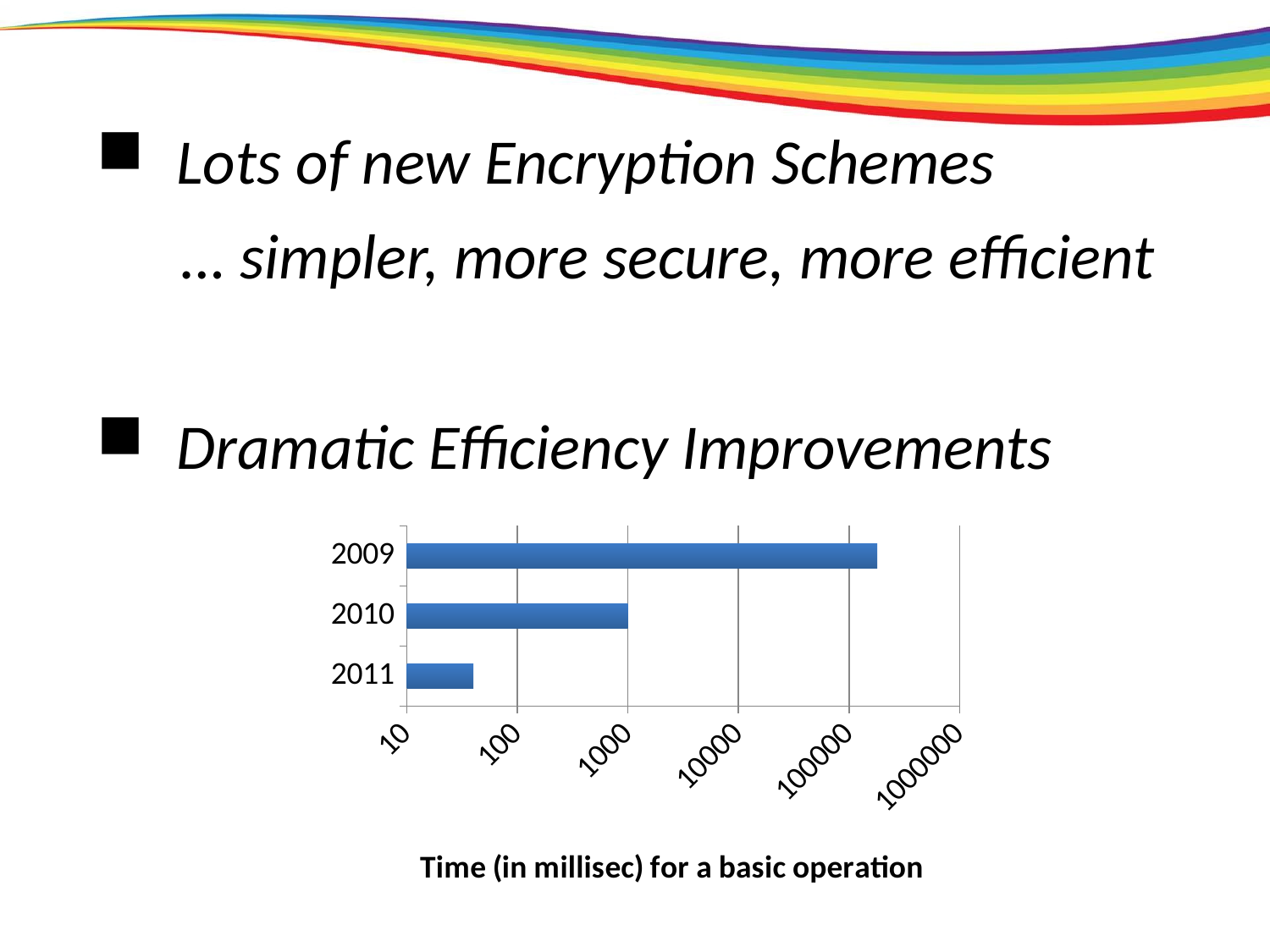
What kind of chart is shown on the slide? bar chart Do the values rise or fall going from 2009 to 2011? fall Is the value for 2011 greater or less than 100? less Which year has the highest time for a basic operation? 2009 Is the value for 2009 greater or less than 100000? greater Which year has the lowest time for a basic operation? 2011 Which year has the larger value, 2010 or 2011? 2010 Which year has the larger value, 2009 or 2010? 2009 How many years (categories) are plotted in the chart? 3 What is the title of the chart? Time (in millisec) for a basic operation Is the value for 2009 greater or less than 10000? greater